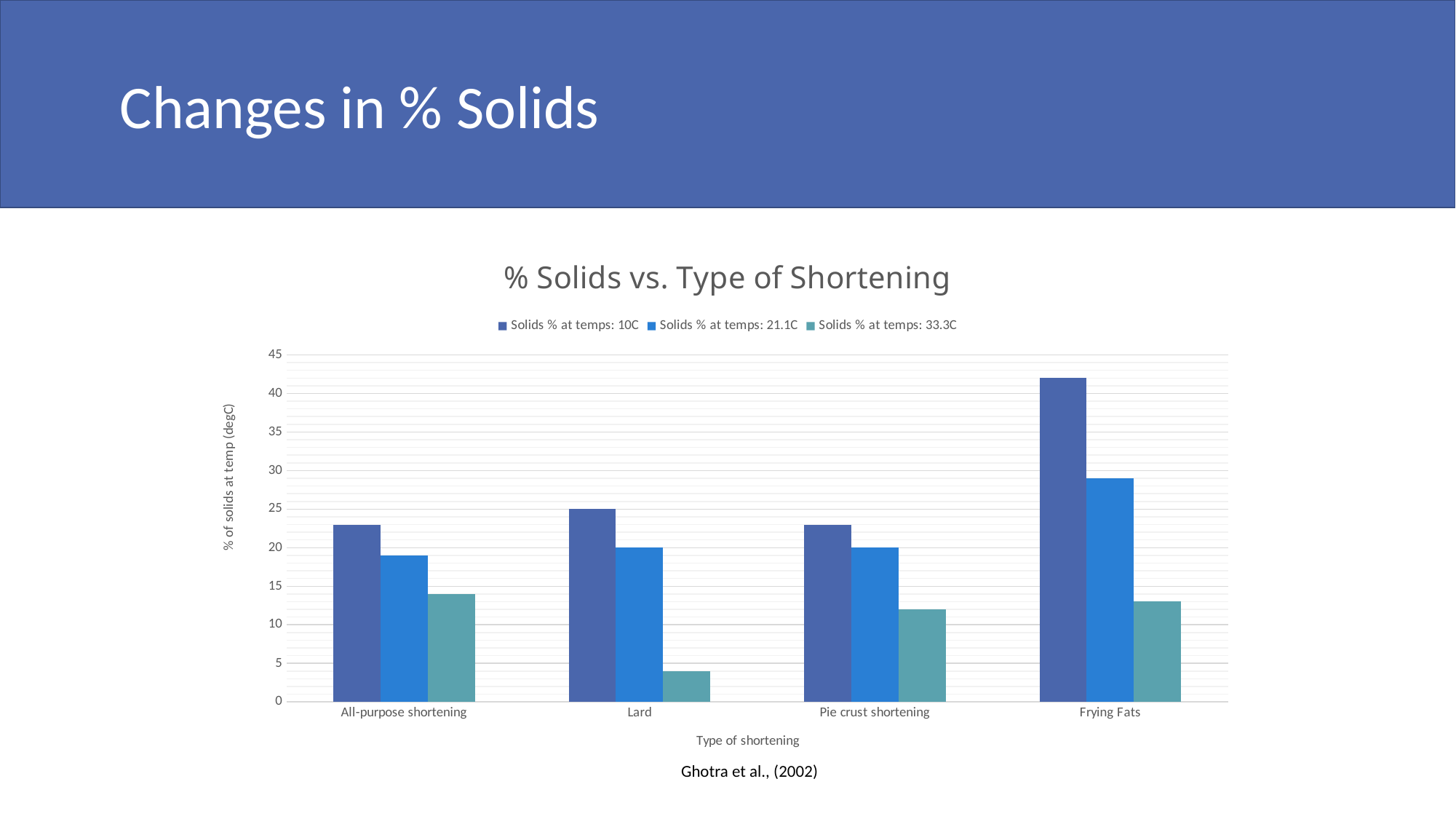
What is the title of the chart? % Solids vs. Type of Shortening Which type of shortening has the lowest Solids % at temps: 33.3C? Lard Is the Solids % at temps: 33.3C for All-purpose shortening greater or less than 10? greater Which type of shortening has the highest Solids % at temps: 10C? Frying Fats Which has a higher Solids % at temps: 21.1C, Frying Fats or Lard? Frying Fats How many series does the legend list? 3 Which has a higher Solids % at temps: 33.3C, Pie crust shortening or Lard? Pie crust shortening How many types of shortening are shown on the x axis? 4 What kind of chart is shown on the slide? bar chart Is the Solids % at temps: 33.3C for Lard greater or less than 5? less What is the x-axis title of the chart? Type of shortening Is the Solids % at temps: 10C for Frying Fats greater or less than 40? greater